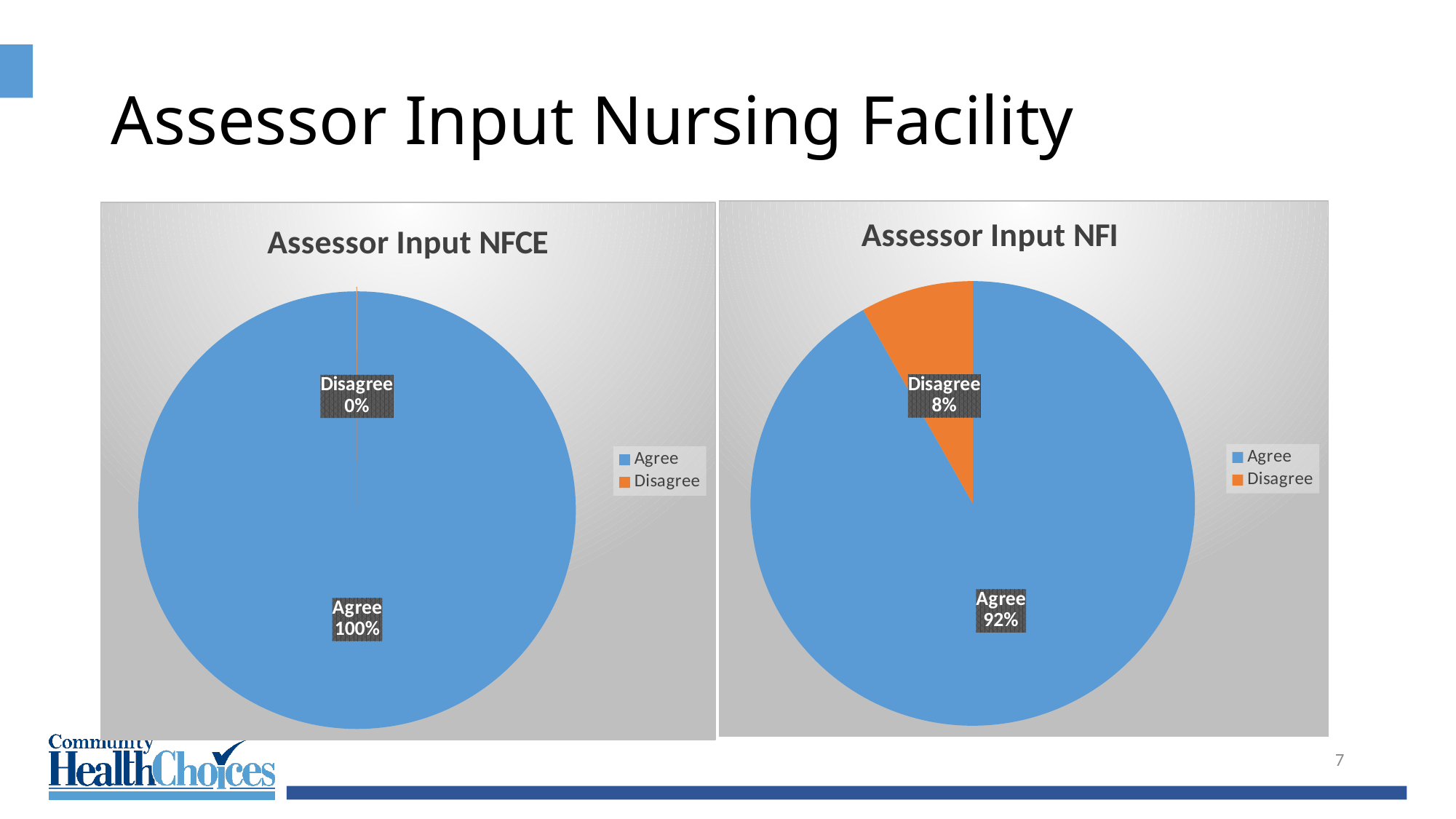
In the 'Assessor Input NFI' chart, what is the difference between the Agree and Disagree percentages? 84% In the 'Assessor Input NFI' chart, what percentage is shown for Agree? 92% In the 'Assessor Input NFCE' chart, what percentage is shown for Disagree? 0% In the 'Assessor Input NFI' chart, what colour represents Disagree? Orange How many charts are shown on the slide? 2 In the 'Assessor Input NFCE' chart, what percentage is shown for Agree? 100% How many entries does the legend of the 'Assessor Input NFI' chart list? 2 In the 'Assessor Input NFI' chart, which slice is the smallest? Disagree What type of chart is 'Assessor Input NFCE'? Pie chart In the 'Assessor Input NFI' chart, which slice is the largest? Agree Which chart has the larger Disagree share, 'Assessor Input NFCE' or 'Assessor Input NFI'? Assessor Input NFI In the 'Assessor Input NFI' chart, what percentage is shown for Disagree? 8%